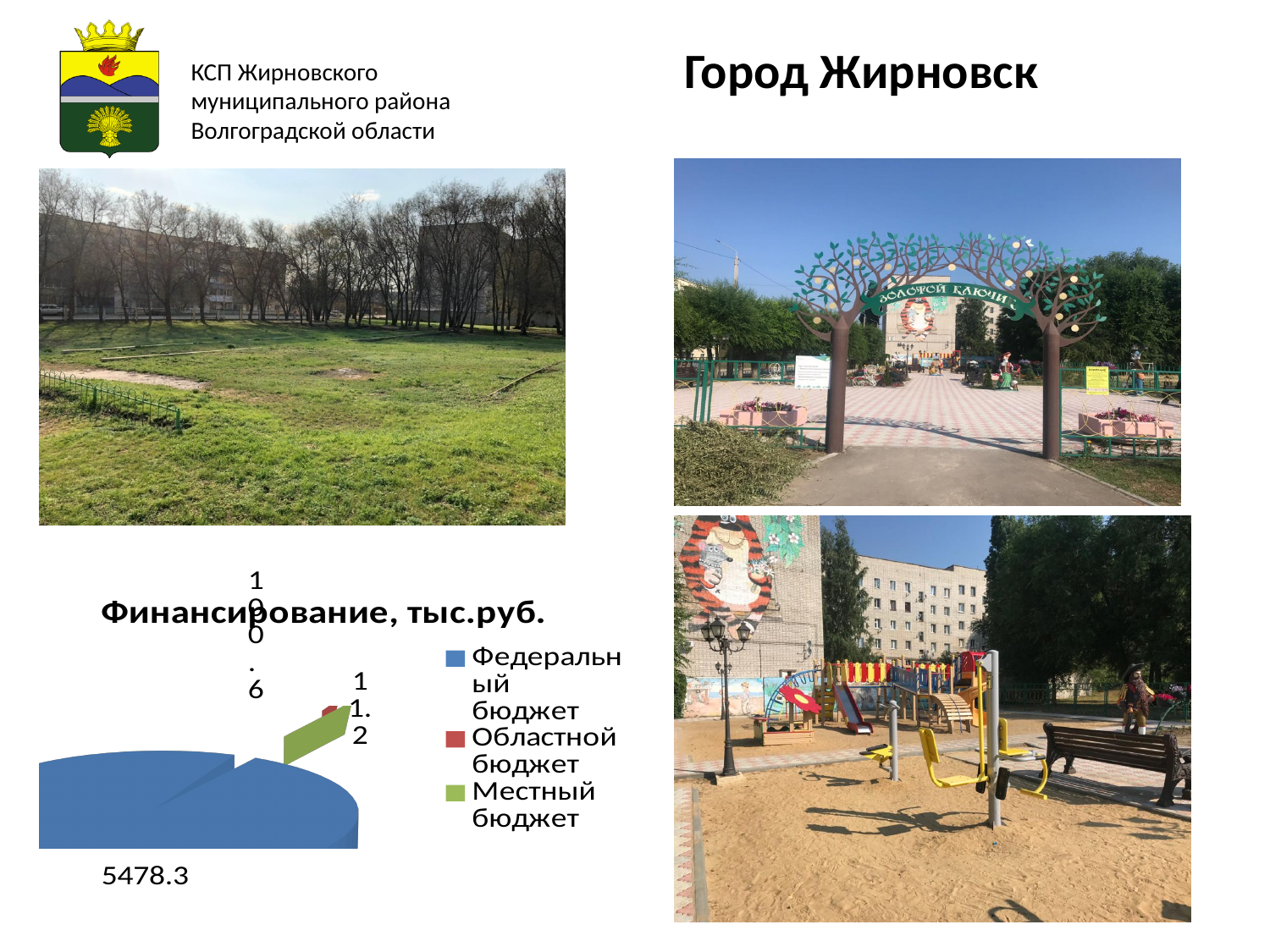
What is the title of the chart on the slide? Финансирование, тыс.руб. Which colour represents Местный бюджет in the pie chart? green What type of chart is shown on the slide? pie chart How many budget sources does the chart's legend list? 3 Which budget source has the largest slice in the pie chart? Федеральный бюджет How many slices does the pie chart have? 3 What is the value shown for Федеральный бюджет in the pie chart? 5478.3 What is the total of all three values shown in the pie chart? 5590.1 Which is larger in the pie chart, Федеральный бюджет or Местный бюджет? Федеральный бюджет